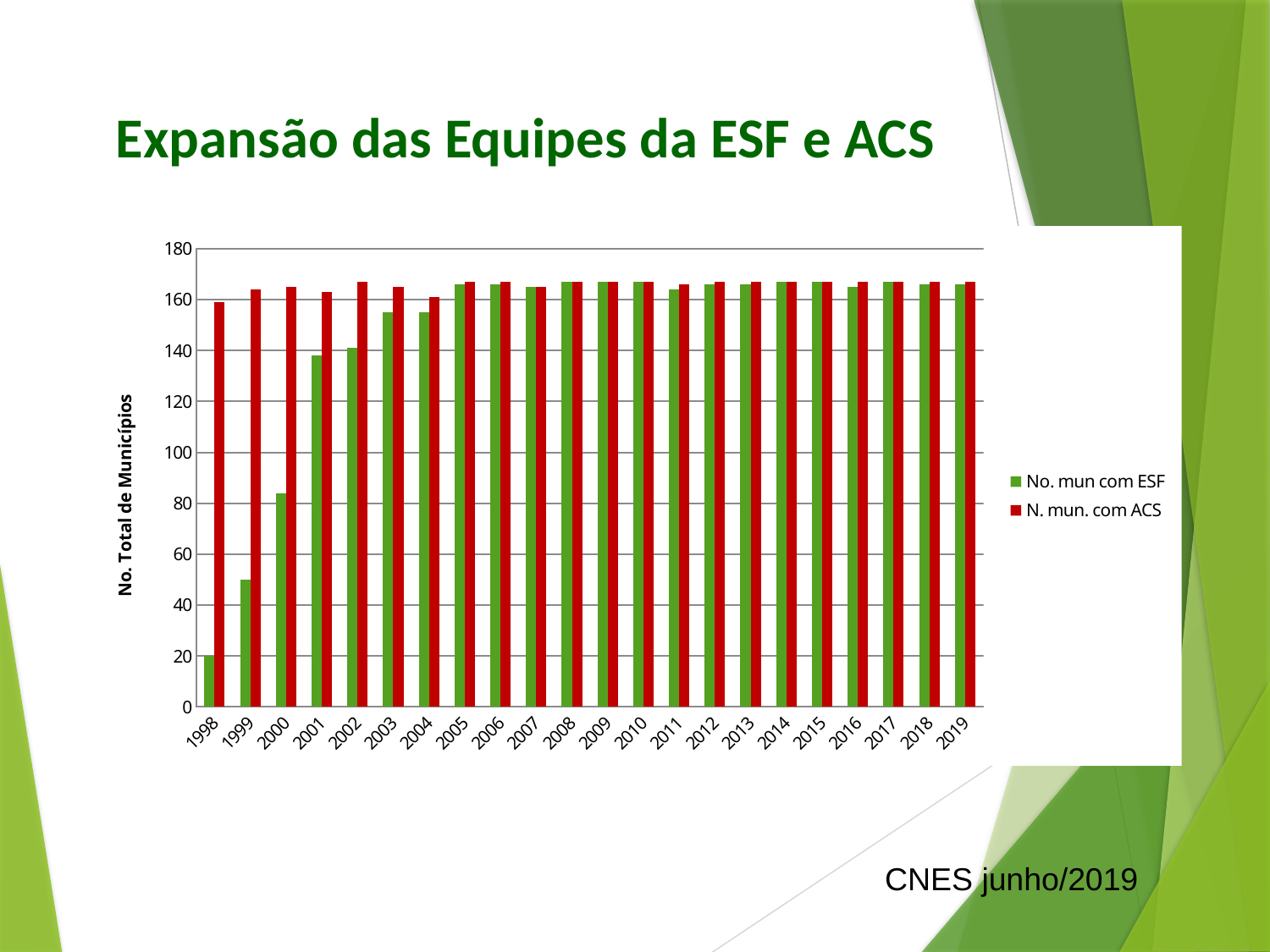
What kind of chart is shown on the slide? bar chart In which year is the value for No. mun com ESF lowest? 1998 In 1998, which series has the larger value: No. mun com ESF or N. mun. com ACS? N. mun. com ACS Is the value for No. mun com ESF in 2000 greater or less than 100? less Is the value for No. mun com ESF in 1998 greater or less than 40? less Does the value for No. mun com ESF rise or fall from 1998 to 2005? rise Is the value for No. mun com ESF in 2002 greater or less than 120? greater What is the title of the y axis? No. Total de Municípios How many years are shown along the x axis? 22 How many series does the legend list? 2